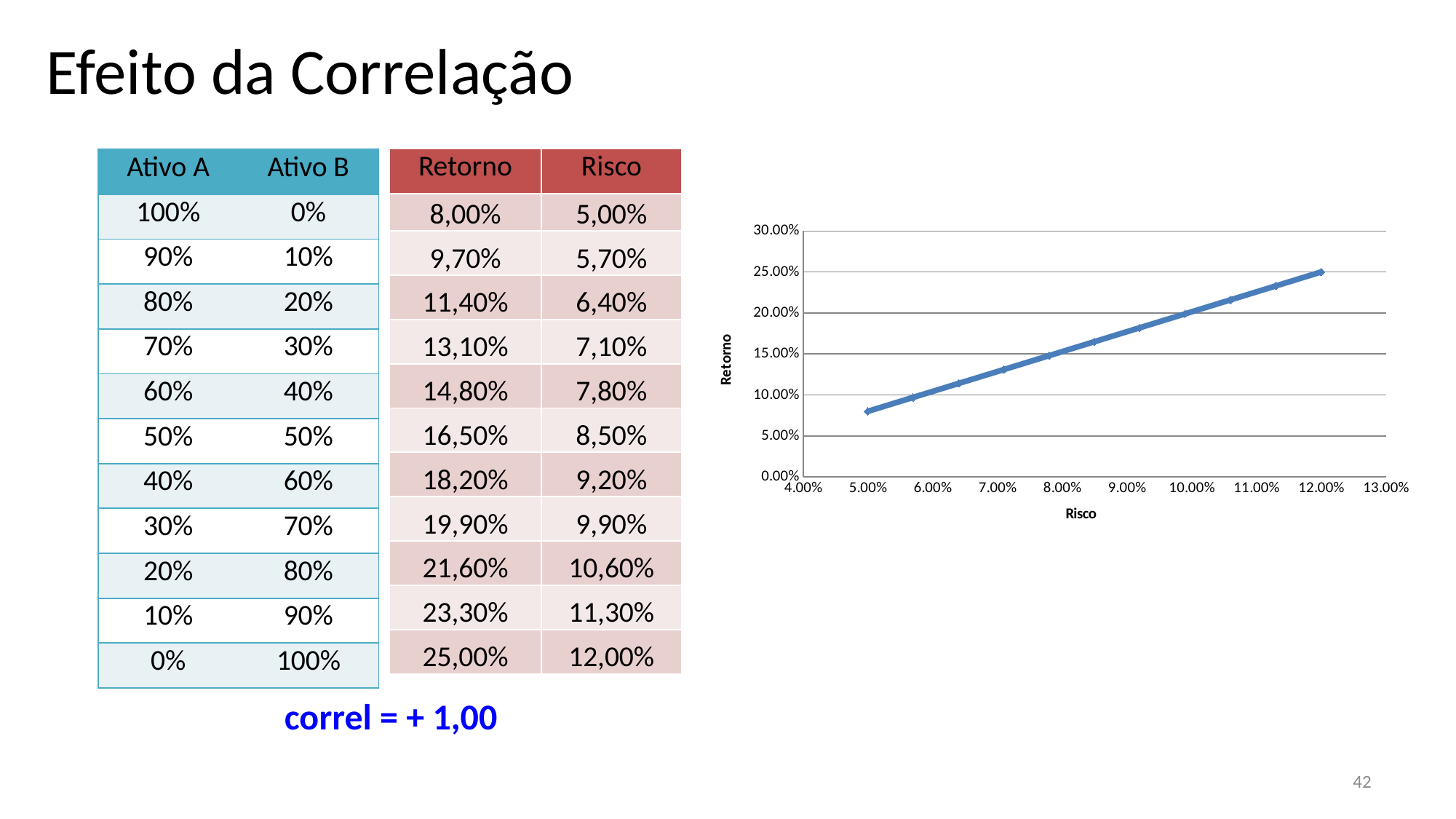
What is the Risco value of the point with the highest Retorno? 12.00% What is the label of the y axis of the chart? Retorno What is the label of the x axis of the chart? Risco Is the Retorno value at the highest Risco point greater or less than 20.00%? greater What is the lowest Risco value plotted on the chart? 5.00% Is the Retorno value at the lowest Risco point greater or less than 10.00%? less Do the values of Retorno rise or fall as Risco increases along the x axis? rise What is the highest Retorno value plotted on the chart? 25.00% Which point has a larger Retorno: the one at 5.00% Risco or the one at 12.00% Risco? the one at 12.00% Risco How many data points are plotted on the chart? 11 What kind of chart is shown on the slide? line chart